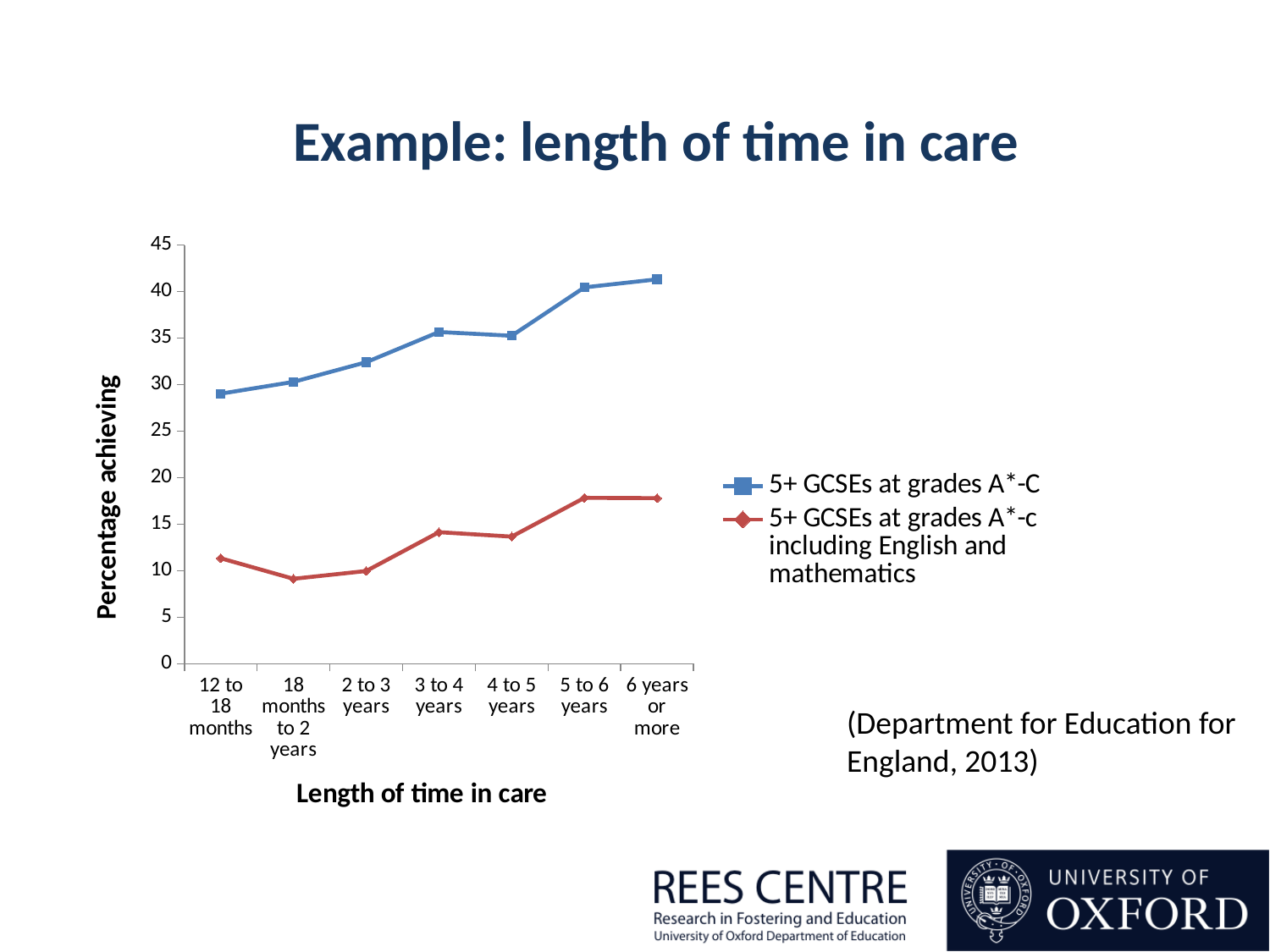
What is the title of the x axis? Length of time in care What is the title of the y axis? Percentage achieving For 5+ GCSEs at grades A*-C, which is higher: the value at 2 to 3 years or the value at 3 to 4 years? 3 to 4 years What kind of chart is shown on the slide? line chart Is the value for 5+ GCSEs at grades A*-C at 12 to 18 months greater or less than 35? less How many series does the legend list? 2 Which series has the higher value at 6 years or more: 5+ GCSEs at grades A*-C, or 5+ GCSEs at grades A*-c including English and mathematics? 5+ GCSEs at grades A*-C Is the value for 5+ GCSEs at grades A*-c including English and mathematics at 5 to 6 years greater or less than 20? less Do the values for 5+ GCSEs at grades A*-C generally rise or fall as length of time in care increases? rise Is the value for 5+ GCSEs at grades A*-c including English and mathematics at 12 to 18 months greater or less than 10? greater How many length-of-time categories are shown on the x axis? 7